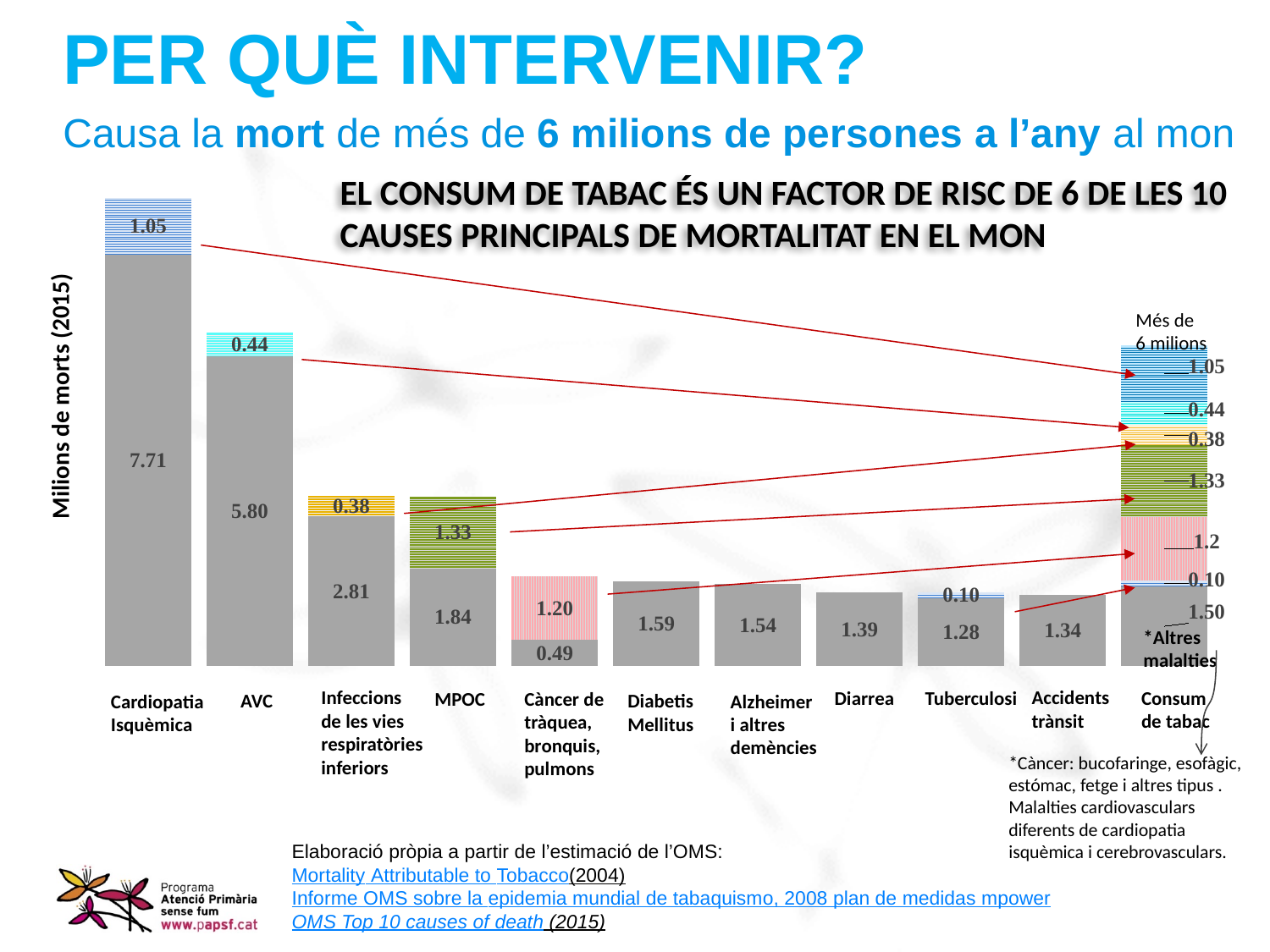
What is the value of the grey segment for Càncer de tràquea, bronquis, pulmons? 0.49 What is the value of the grey (non-tobacco) segment for Cardiopatia Isquèmica? 7.71 What is the value of the striped segment for Tuberculosi? 0.10 What is the difference between the grey segment of Cardiopatia Isquèmica (7.71) and the grey segment of AVC (5.80)? 1.91 How many categories (bars) are shown on the x axis? 11 What is the value of the tobacco-attributable (striped) segment for MPOC? 1.33 Which is larger, the grey value for Diarrea or the grey value for Tuberculosi? Diarrea What is the label of the y axis? Milions de morts (2015) What is the total of the stacked bar for MPOC (1.84 + 1.33)? 3.17 What is the value shown for Diabetis Mellitus? 1.59 Which cause of death has the tallest bar? Cardiopatia Isquèmica What is the total of the stacked bar for Cardiopatia Isquèmica (7.71 + 1.05)? 8.76